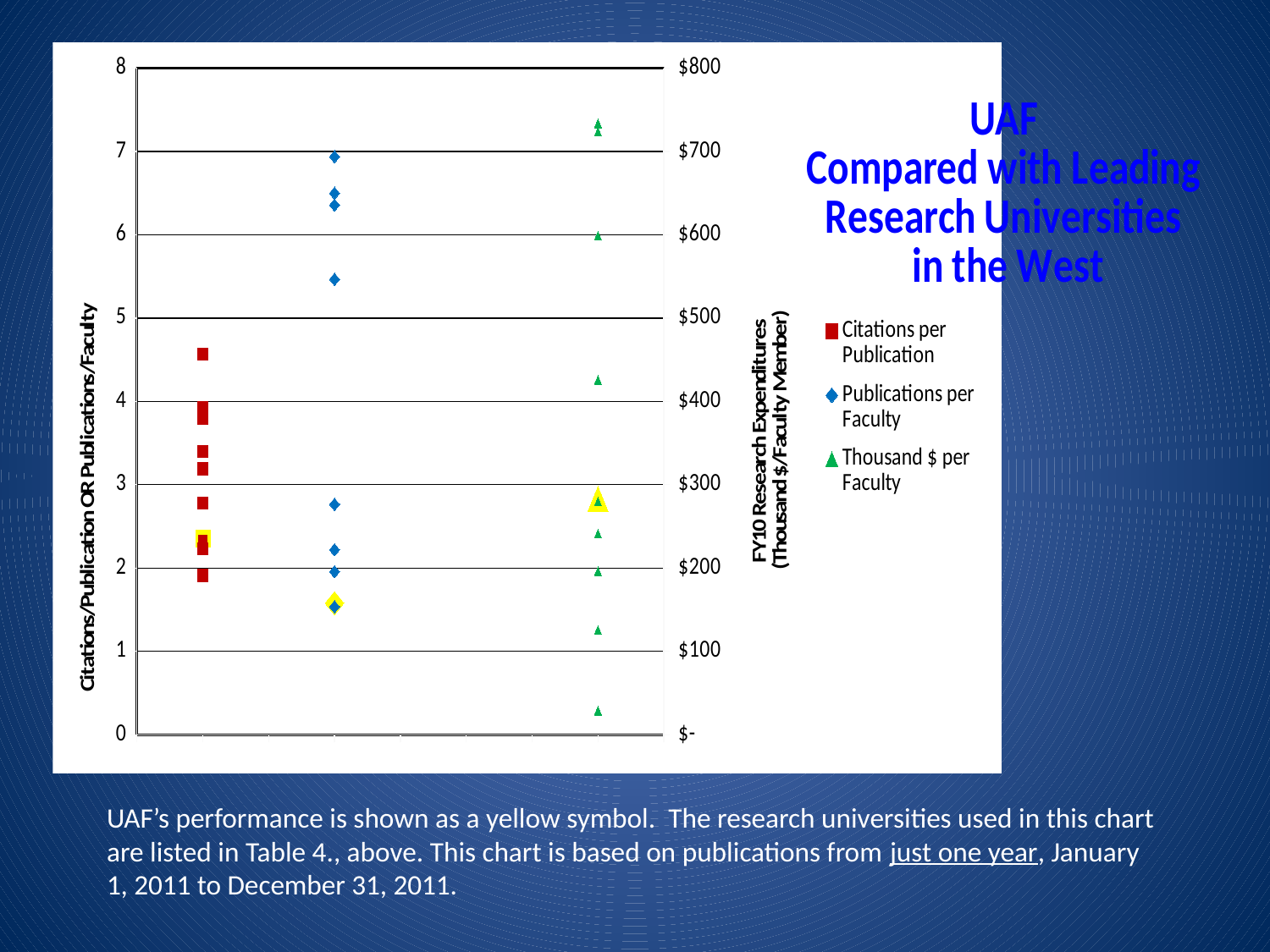
Is UAF's Publications per Faculty value (yellow symbol) greater or less than 2? less Which series is plotted with green triangles? Thousand $ per Faculty Is the highest Citations per Publication value greater or less than 4? greater Is the highest Thousand $ per Faculty value greater or less than $700? greater What is the title of the chart on the slide? UAF Compared with Leading Research Universities in the West How many series does the chart legend list? 3 What kind of chart is shown on the slide? scatter chart